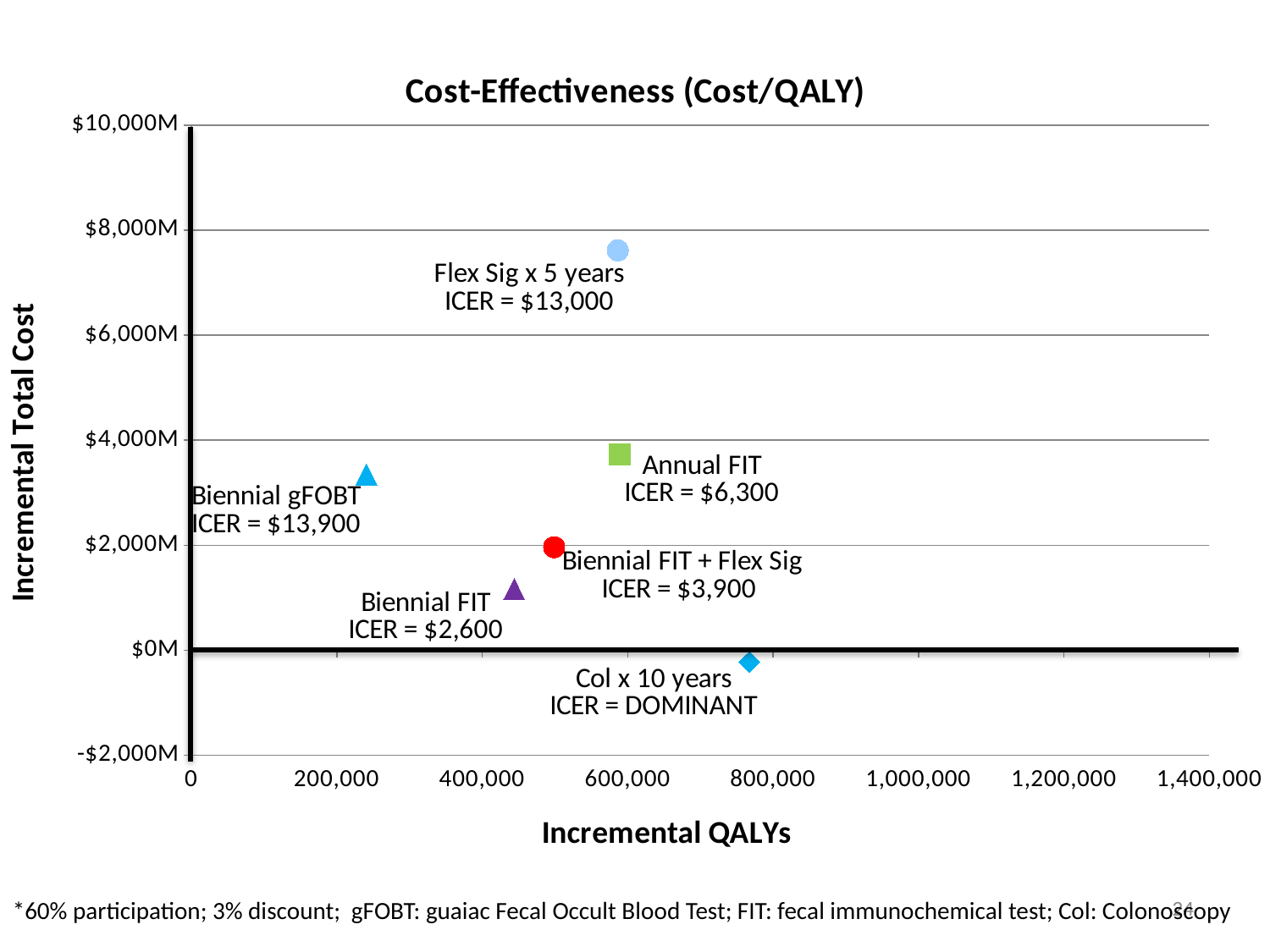
Which strategy has the lowest incremental total cost? Col x 10 years Which has the higher incremental total cost, Annual FIT or Biennial FIT? Annual FIT What is the title of the chart? Cost-Effectiveness (Cost/QALY) What is the ICER printed for Annual FIT? $6,300 Which strategy has the highest incremental total cost? Flex Sig x 5 years What ICER is printed for Col x 10 years? DOMINANT Is the incremental total cost for Flex Sig x 5 years greater or less than $8,000M? less Which strategy has the fewest incremental QALYs? Biennial gFOBT How many strategies (data points) are plotted on the chart? 6 What is the ICER printed for Biennial FIT + Flex Sig? $3,900 What kind of chart is shown on the slide? Scatter chart What is the ICER printed for Biennial gFOBT? $13,900